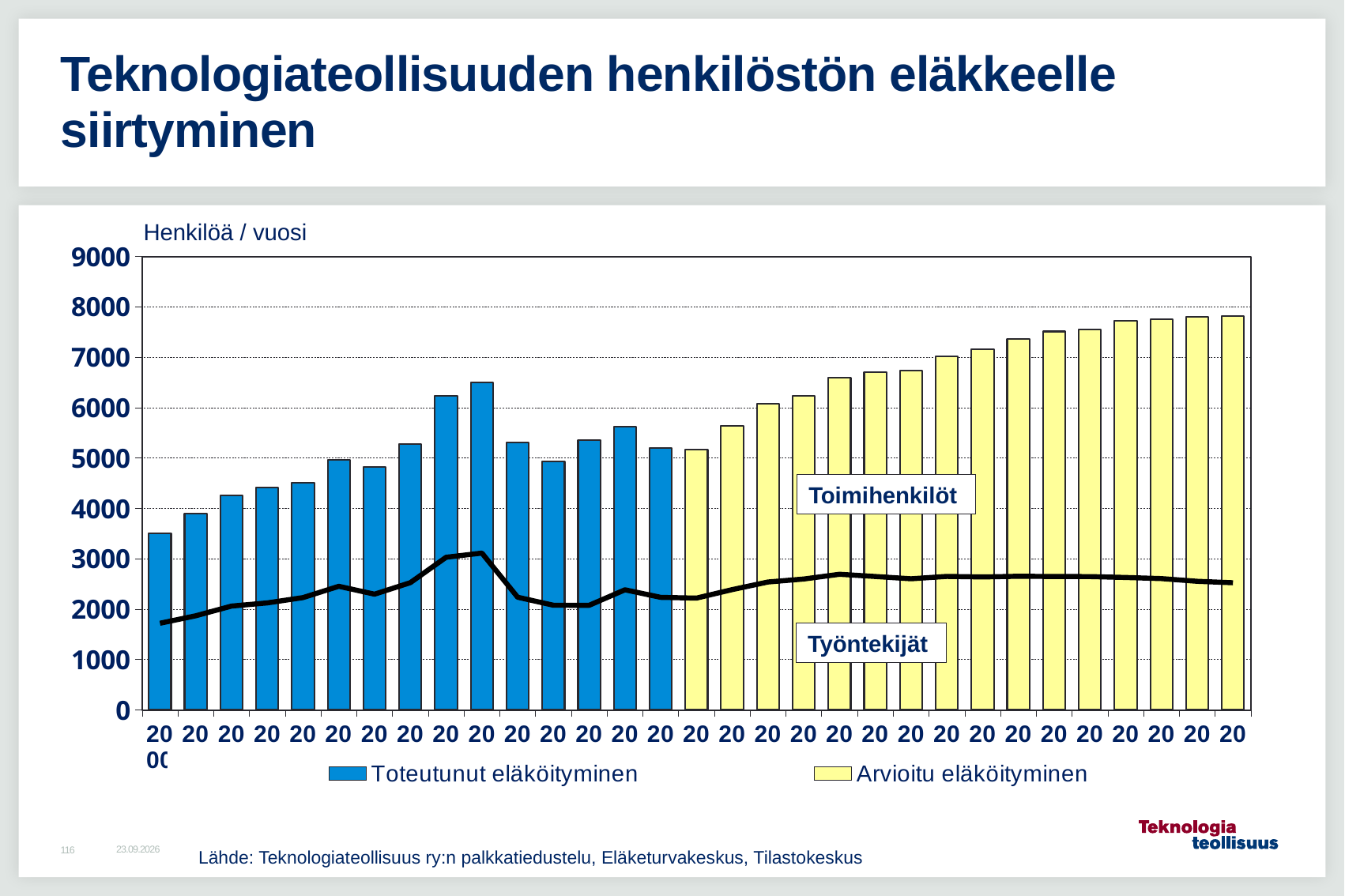
What is the highest value shown on the vertical axis? 9000 Do the yellow (Arvioitu eläköityminen) bars rise or fall from left to right? rise What kind of chart is shown on the slide? bar chart (with a line) What is the label shown above the vertical axis? Henkilöä / vuosi How many series does the legend list? 2 Is the value of the leftmost blue bar greater or less than 3000? greater Is the value of the tallest blue bar greater or less than 6000? greater Is the value of the black line at the leftmost point greater or less than 2000? less Which is larger, the leftmost bar or the rightmost bar? the rightmost bar Which is larger, the tallest blue bar or the tallest yellow bar? the tallest yellow bar What are the two series named in the legend? Toteutunut eläköityminen and Arvioitu eläköityminen